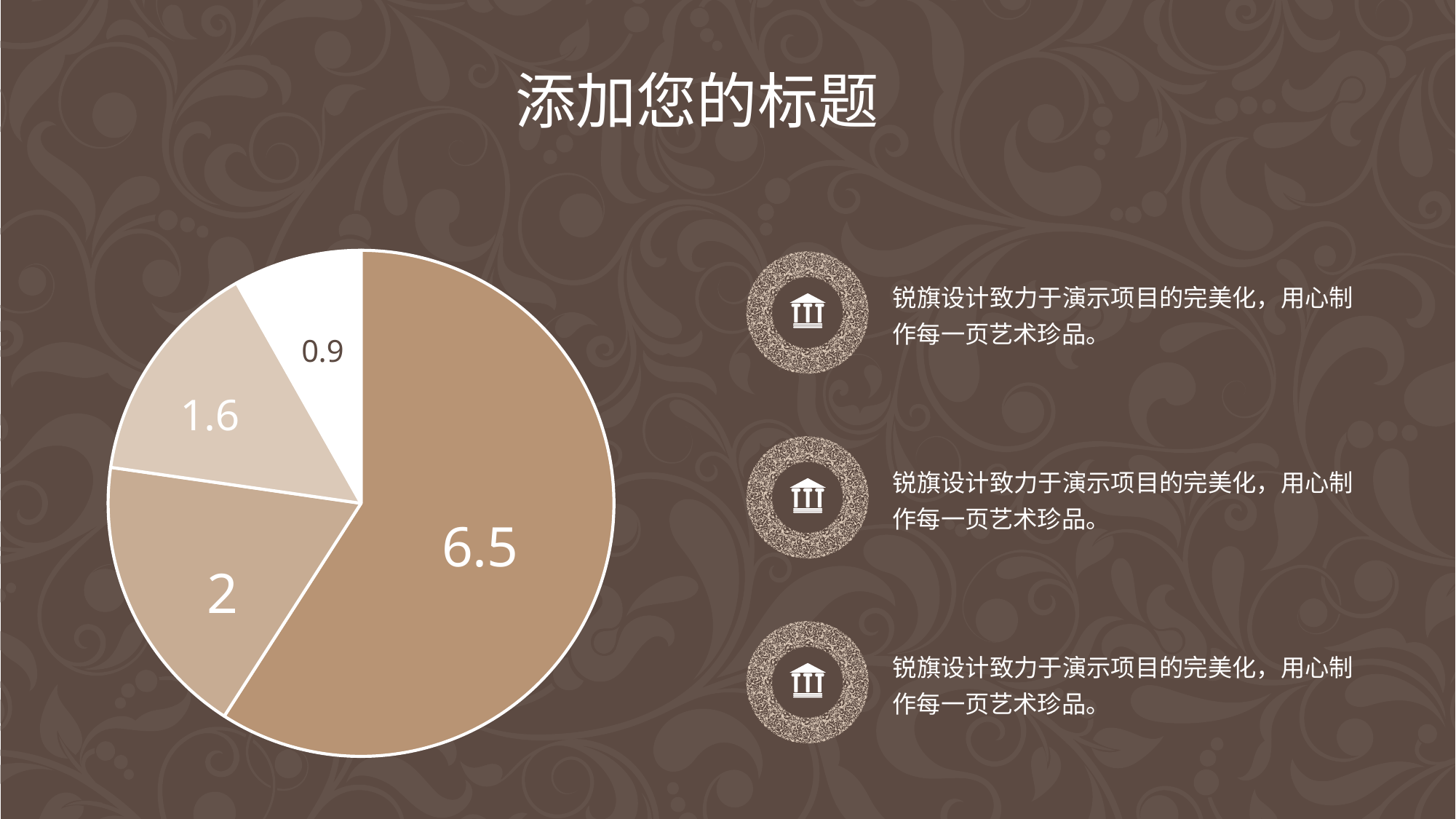
What is the value of the smallest slice of the pie chart? 0.9 What is the difference between the slice labelled 6.5 and the slice labelled 2? 4.5 What is the total of all the slice values in the pie chart? 11 Which slice is larger, the one labelled 1.6 or the one labelled 0.9? 1.6 How many slices does the pie chart have? 4 Does the pie chart have a legend? No What kind of chart is shown on the slide? pie chart What is the difference between the slice labelled 2 and the slice labelled 1.6? 0.4 What is the title shown above the chart on the slide? 添加您的标题 What value is labelled on the white slice of the pie chart? 0.9 What value is labelled on the slice at the lower left of the pie chart? 2 What is the value of the largest slice of the pie chart? 6.5